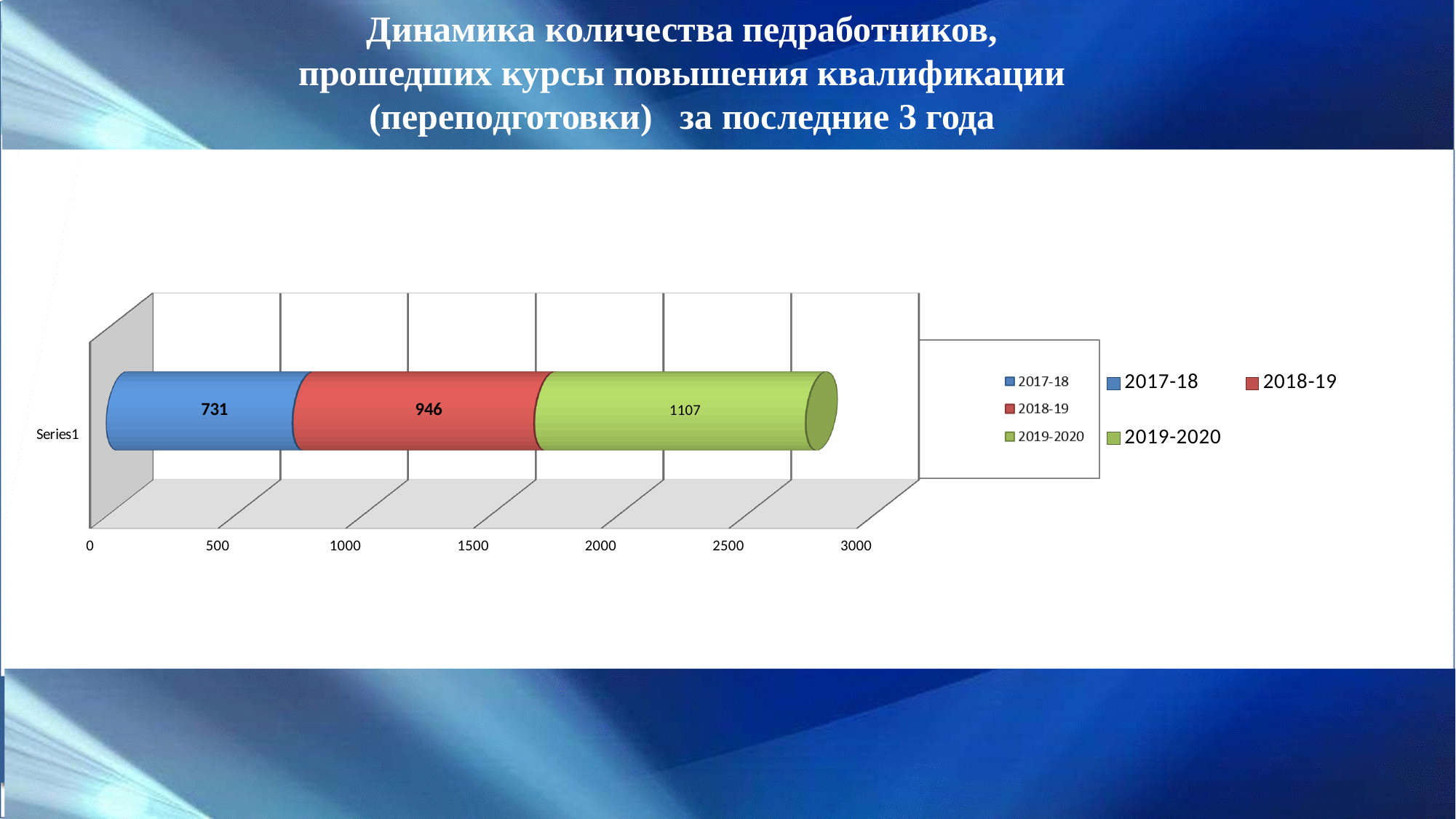
What is the difference between the values for 2018-19 and 2017-18? 215 Which series has the highest value? 2019-2020 What is the value for 2019-2020? 1107 Do the values rise or fall from 2017-18 to 2019-2020? Rise Which series has the lowest value? 2017-18 How many series does the legend list? 3 What is the total of the stacked bar? 2784 What kind of chart is shown on the slide? Stacked bar chart What is the value for 2018-19? 946 Which is larger, the value for 2017-18 or the value for 2019-2020? 2019-2020 What is the value for 2017-18? 731 What is the difference between the values for 2019-2020 and 2018-19? 161